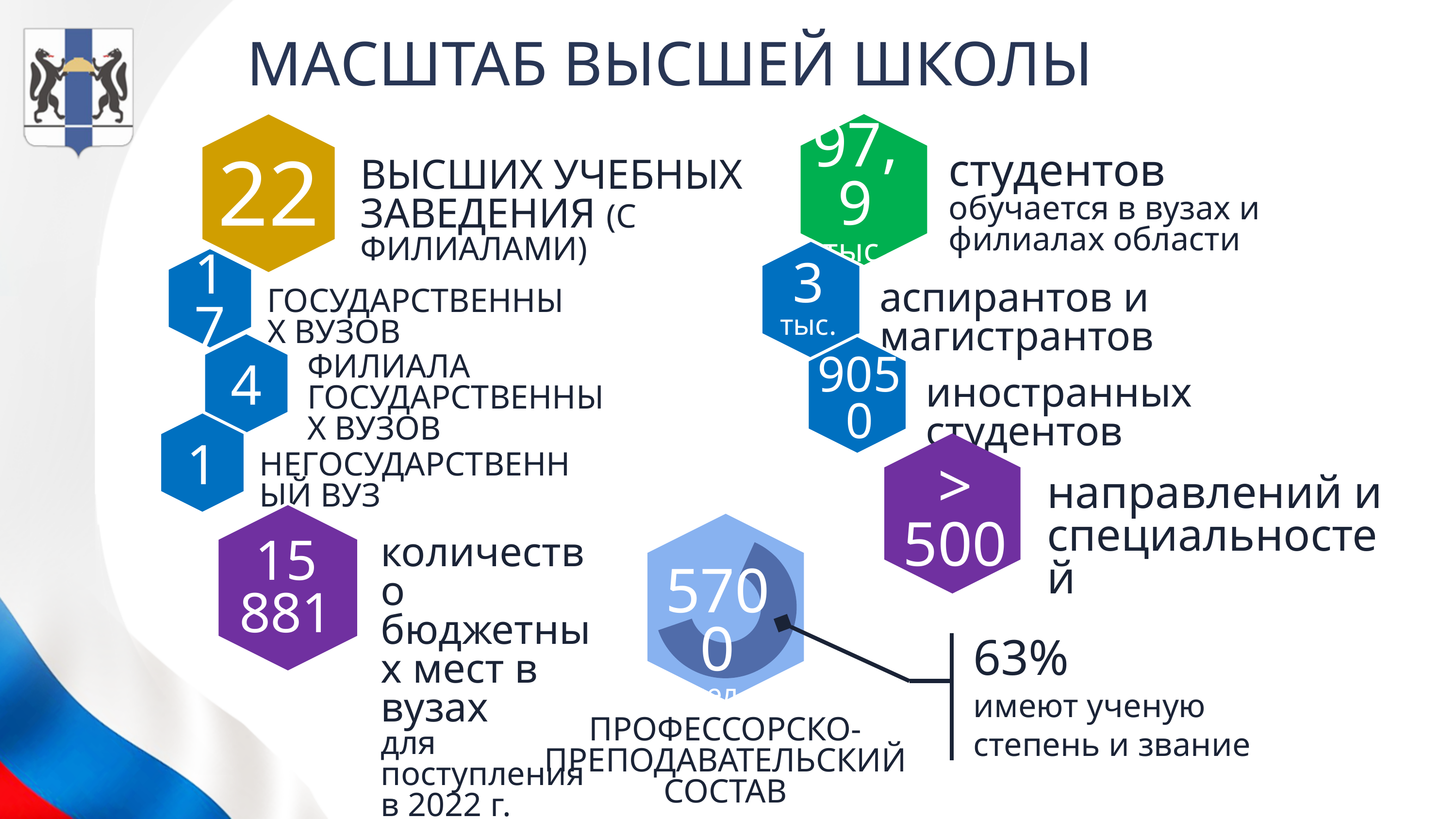
In the doughnut chart for the professorial-teaching staff, what share of staff have an academic degree and title? 63% What total number of professorial-teaching staff is printed in the centre of the doughnut chart? 5700 What does the 63% slice of the doughnut chart represent? имеют ученую степень и звание What kind of chart is shown behind the number 5700 in the professorial-teaching staff section? doughnut chart What is the label under the doughnut chart describing the group it refers to? ПРОФЕССОРСКО-ПРЕПОДАВАТЕЛЬСКИЙ СОСТАВ Is the share of teaching staff with an academic degree and title shown in the doughnut chart greater or less than 50%? greater